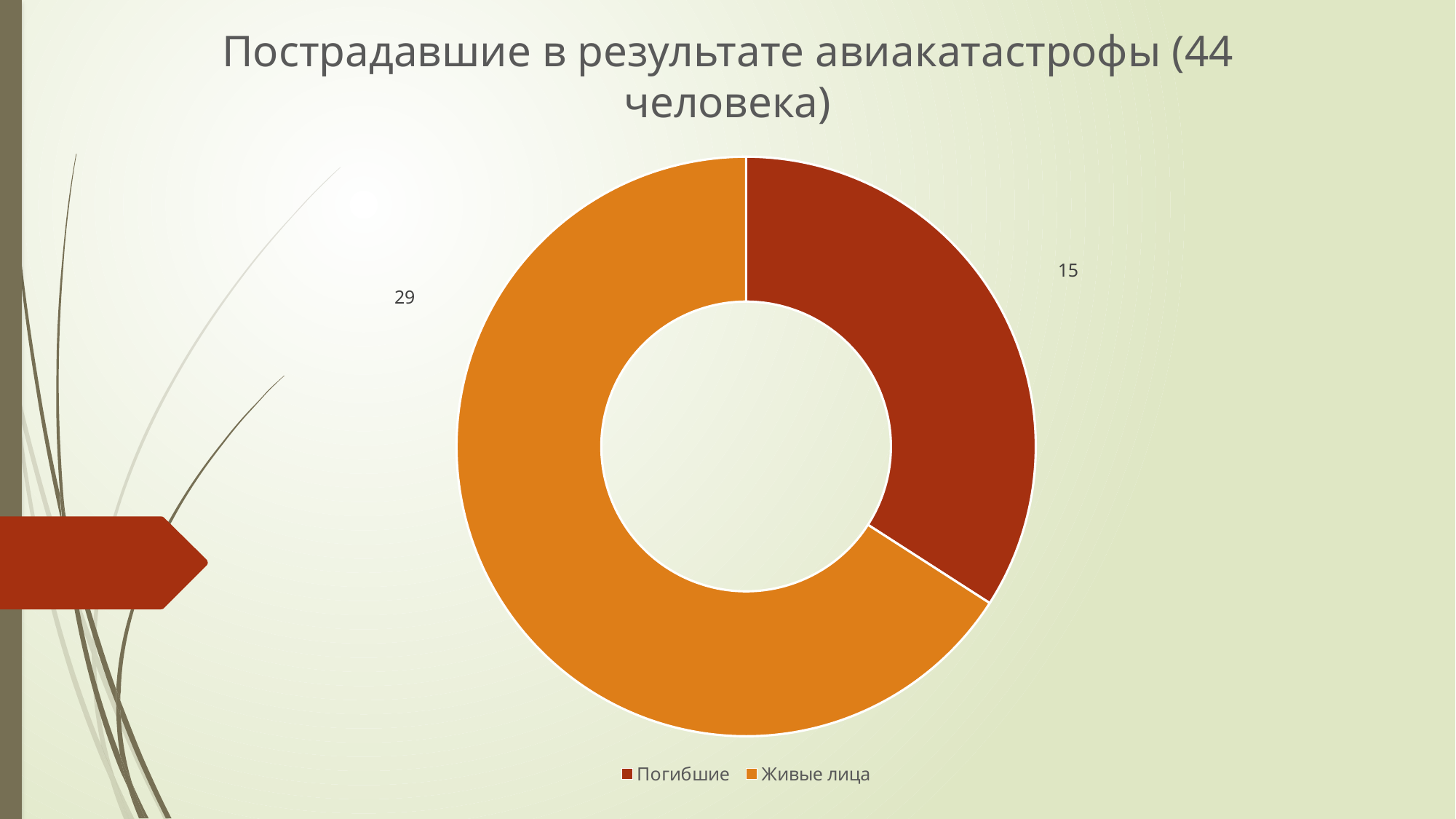
Which is larger, the value for Погибшие or the value for Живые лица? Живые лица What is the difference between the values for Живые лица and Погибшие? 14 What is the value for Погибшие? 15 Which colour represents Погибшие in the chart? Dark red What is the value for Живые лица? 29 What is the title of the chart? Пострадавшие в результате авиакатастрофы (44 человека) Which category has the smallest value? Погибшие How many entries does the legend list? 2 Which category has the largest value? Живые лица How many categories does the chart show? 2 What is the total of the two values shown in the chart? 44 What kind of chart is shown on the slide? Doughnut chart